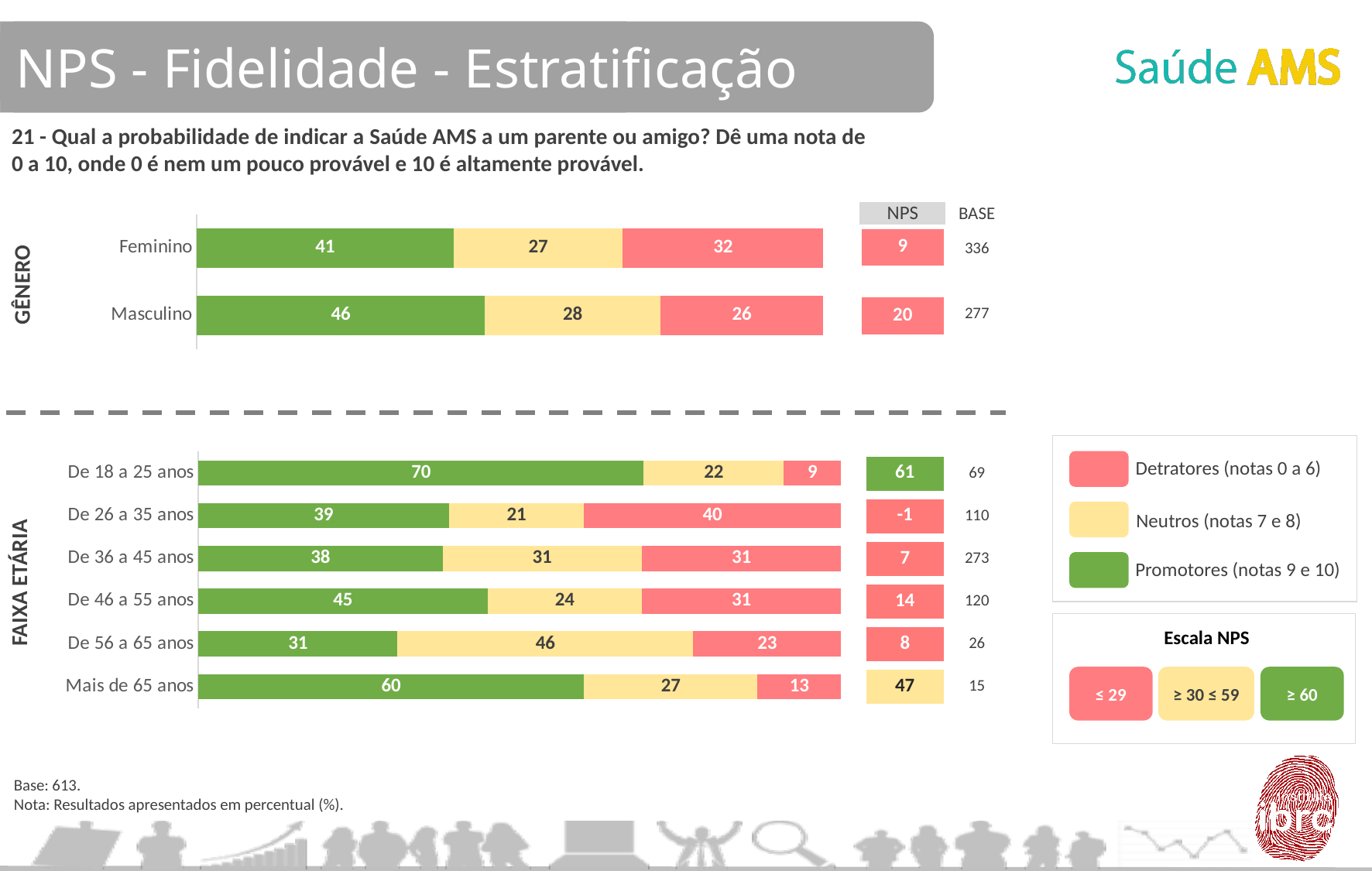
In the FAIXA ETÁRIA chart, what is the NPS for Mais de 65 anos? 47 In the FAIXA ETÁRIA chart, what is the Neutros value for De 56 a 65 anos? 46 What type of chart is used to show the GÊNERO and FAIXA ETÁRIA results? Stacked bar chart In the GÊNERO chart, what is the Detratores value for Masculino? 26 In the FAIXA ETÁRIA chart, which is larger: the Detratores value for De 26 a 35 anos or for De 36 a 45 anos? De 26 a 35 anos In the GÊNERO chart, what is the NPS shown for Masculino? 20 In the FAIXA ETÁRIA chart, which age group has the highest Promotores value? De 18 a 25 anos In the GÊNERO chart, what is the difference between the Promotores values for Masculino and Feminino? 5 In the FAIXA ETÁRIA chart, how many age groups are shown? 6 How many series does the legend list? 3 In the FAIXA ETÁRIA chart, which age group has the lowest NPS? De 26 a 35 anos In the GÊNERO chart, what is the Promotores value for Feminino? 41